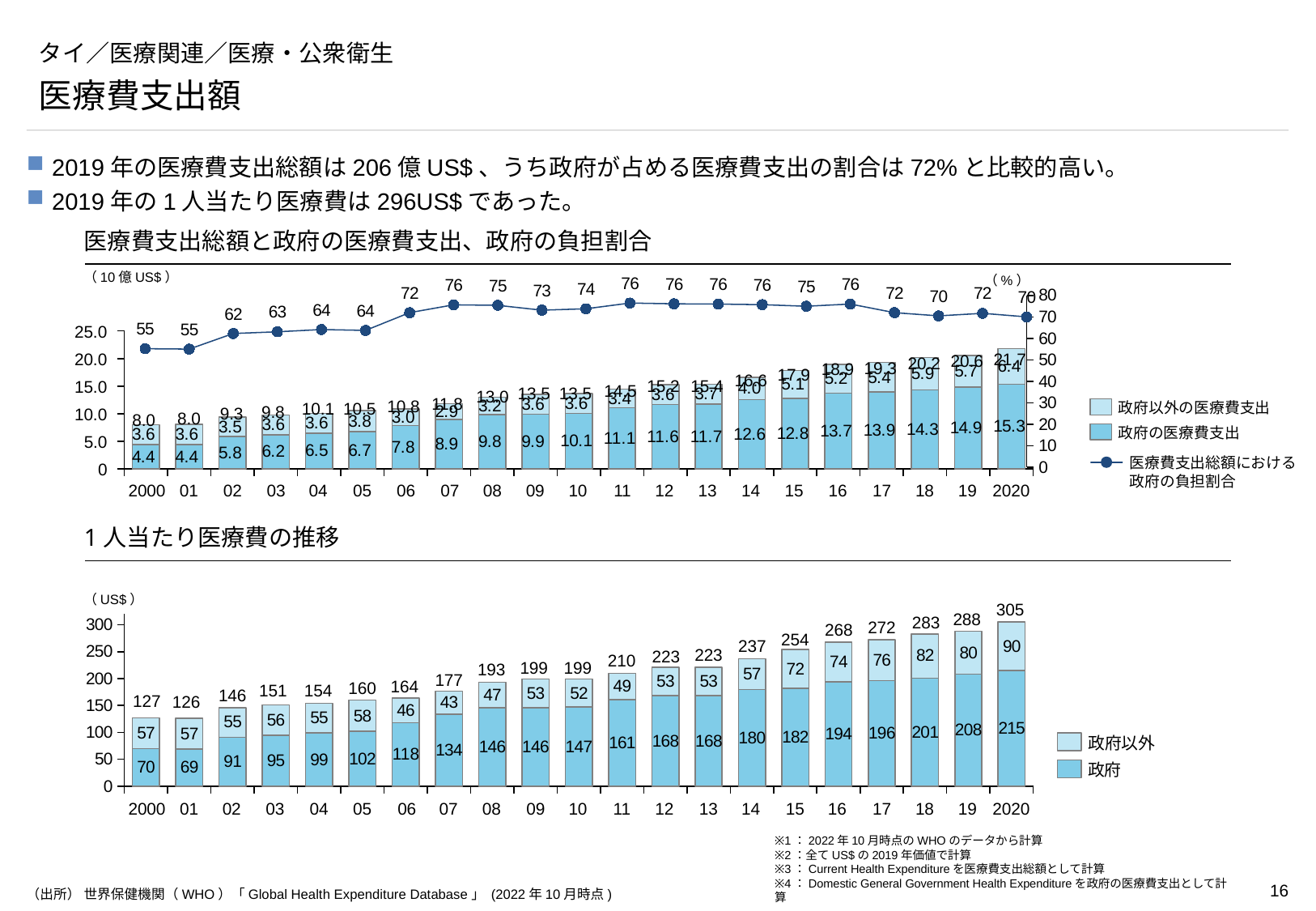
In the bottom chart, do the total per-capita values generally rise or fall from 2000 to 2020? Rise In the bottom chart, what is the value of 政府 for 2010? 147 What kind of chart is the bottom chart (1人当たり医療費の推移)? Stacked bar chart In the top chart, what is the difference between the total health expenditure in 2020 and in 2019? 1.1 In the top chart, what is the value of 政府の医療費支出 for 2019? 14.9 In the top chart, how many series does the legend list? 3 In the bottom chart (1人当たり医療費の推移), what is the total per-capita health expenditure in 2015? 254 In the top chart, how many years are shown on the x axis? 21 In the bottom chart, what is the difference between the 政府以外 value in 2020 and in 2019? 10 In the top chart, which year has the highest total health expenditure (stacked bar total)? 2020 In the bottom chart, which year has the lowest total per-capita health expenditure? 2001 In the top chart (医療費支出総額と政府の医療費支出、政府の負担割合), what is the government's share of total health expenditure (政府の負担割合) in 2007? 76